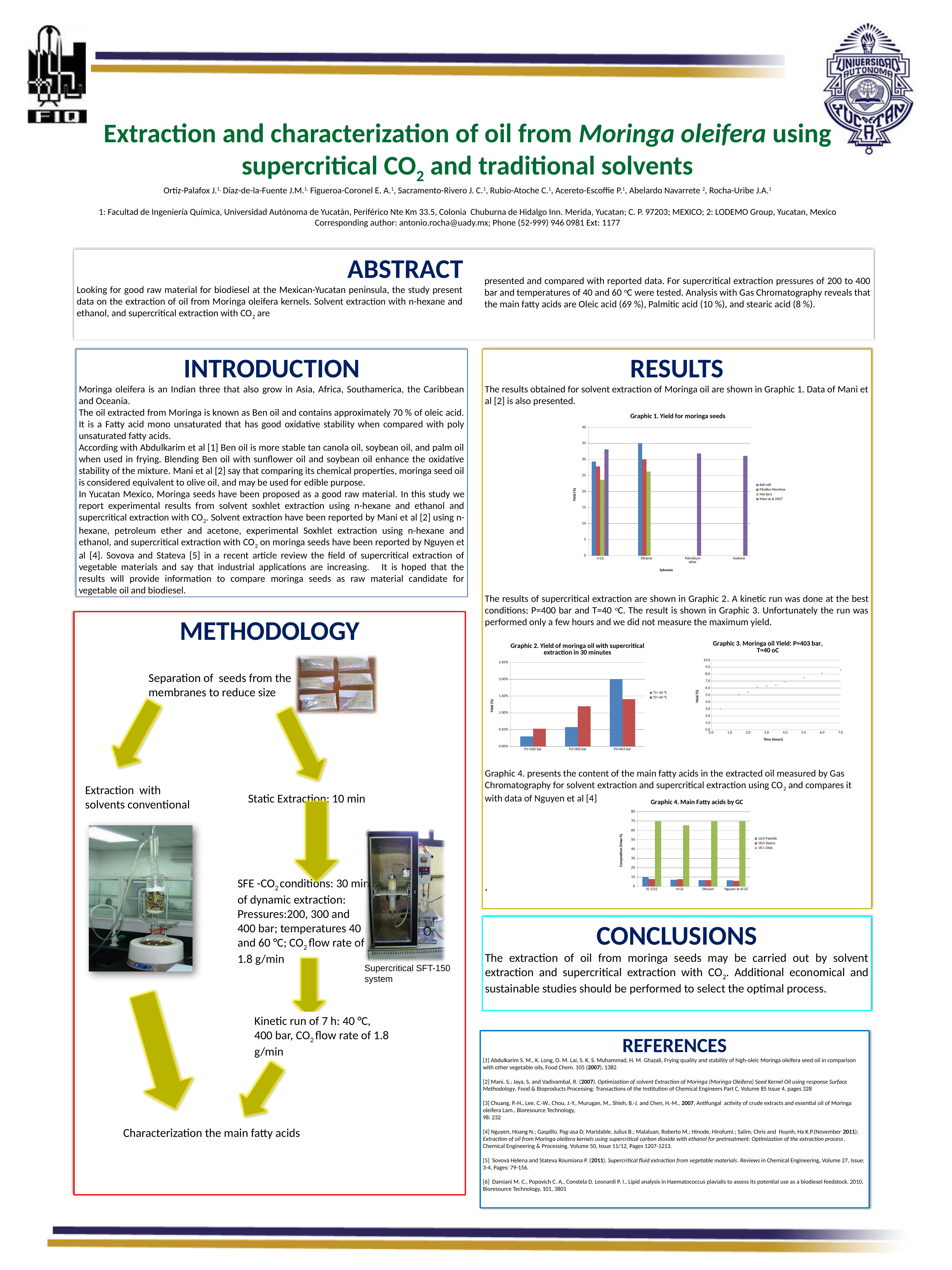
In Graphic 3 (Moringa oil Yield: P=403 bar, T=40 oC), does the yield rise or fall as time increases? rise In Graphic 2 (Yield of moringa oil with supercritical extraction in 30 minutes), how many pressure categories are shown? 3 In Graphic 1 (Yield for moringa seeds), how many solvent categories are shown on the x axis? 4 In Graphic 2 (Yield of moringa oil with supercritical extraction in 30 minutes), which is larger at P2=300 bar: T1=40 °C or T2=60 °C? T2=60 °C In Graphic 2 (Yield of moringa oil with supercritical extraction in 30 minutes), is the T1=40 °C value for P3=403 bar greater or less than 1.50%? greater In Graphic 4 (Main Fatty acids by GC), how many series does the legend list? 3 In Graphic 4 (Main Fatty acids by GC), is the 18:1 Oleic value for SC-CO2 greater or less than 60? greater In Graphic 2 (Yield of moringa oil with supercritical extraction in 30 minutes), how many series does the legend list? 2 In Graphic 1 (Yield for moringa seeds), which series has the highest bar for Ethanol? Ball mill In Graphic 1 (Yield for moringa seeds), is the Ball mill value for Ethanol greater or less than 30? greater In Graphic 2 (Yield of moringa oil with supercritical extraction in 30 minutes), which pressure has the highest yield for T1=40 °C? P3=403 bar In Graphic 1 (Yield for moringa seeds), how many series does the legend list? 4